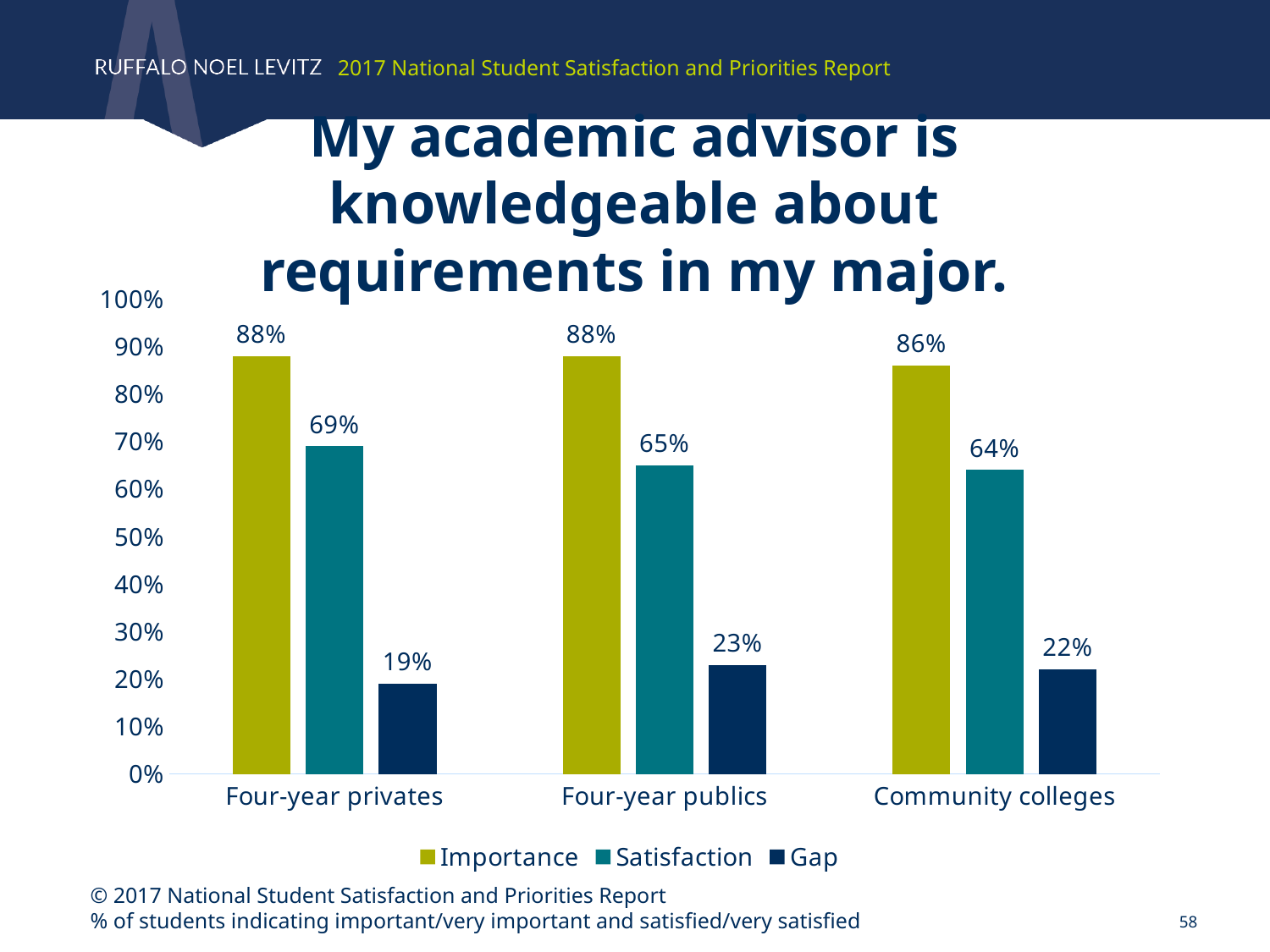
Which category has the lowest Gap value? Four-year privates Is the Satisfaction value for Four-year publics greater or less than 60%? greater What is the difference between Importance and Satisfaction for Four-year publics? 23% What is the Gap value for Four-year publics? 23% What is the Satisfaction value for Community colleges? 64% How many series does the legend list? 3 How many categories are shown on the x axis? 3 What is the Importance value for Four-year privates? 88% Which series is shown in dark navy blue in the legend? Gap Which is larger, the Gap for Community colleges or the Gap for Four-year privates? Community colleges What kind of chart is shown on the slide? Bar chart Which category has the highest Satisfaction value? Four-year privates